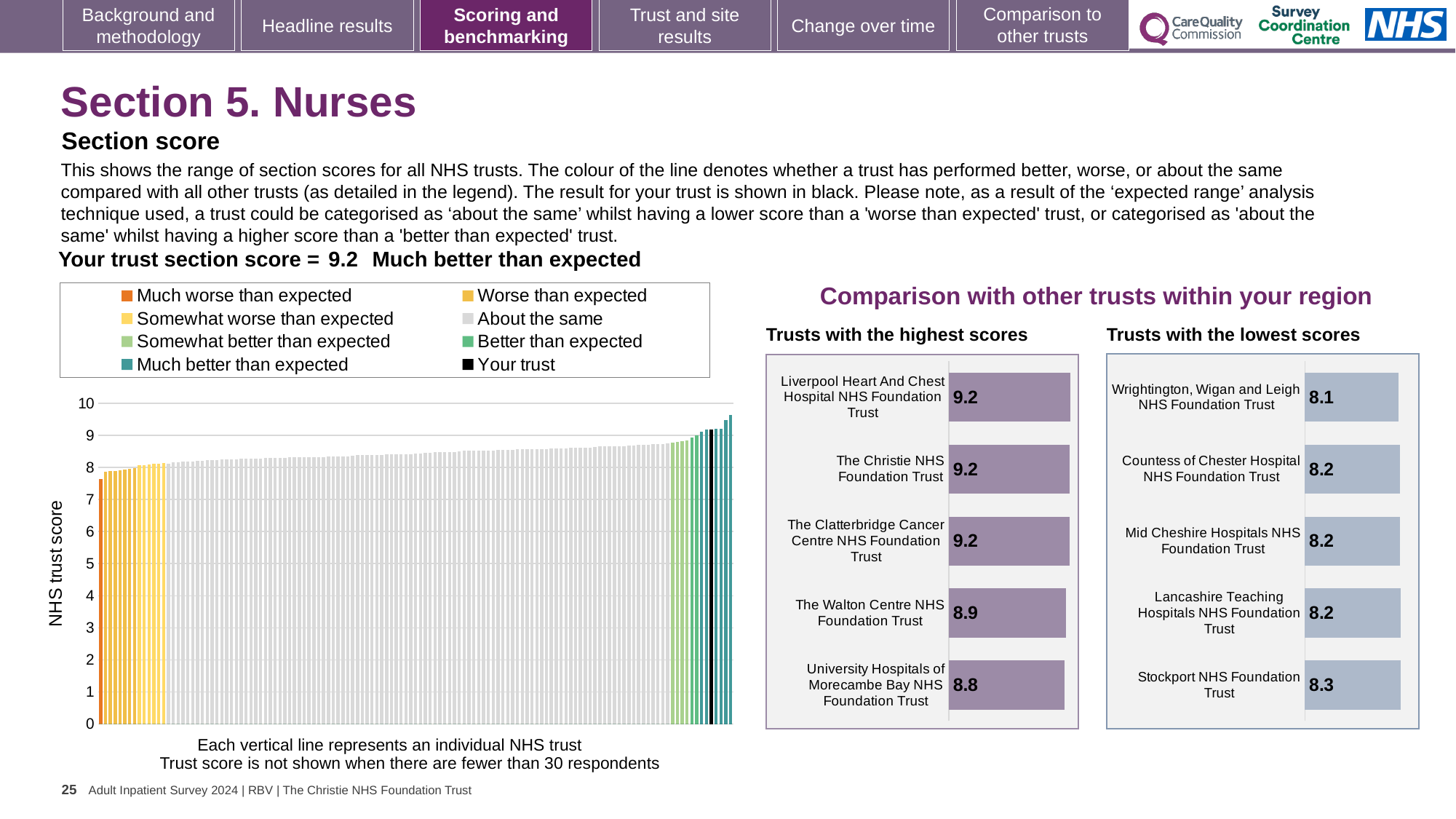
In the 'Trusts with the lowest scores' chart, what is the score for Wrightington, Wigan and Leigh NHS Foundation Trust? 8.1 What kind of chart is the 'Trusts with the highest scores' chart? Bar chart In the 'Trusts with the lowest scores' chart, what is the score for Stockport NHS Foundation Trust? 8.3 How many entries does the legend of the NHS trust score chart on the left list? 8 In the 'Trusts with the highest scores' chart, which has the larger score: The Walton Centre NHS Foundation Trust or University Hospitals of Morecambe Bay NHS Foundation Trust? The Walton Centre NHS Foundation Trust In the 'Trusts with the lowest scores' chart, which trust has the lowest score? Wrightington, Wigan and Leigh NHS Foundation Trust In the 'Trusts with the highest scores' chart, what is the score for University Hospitals of Morecambe Bay NHS Foundation Trust? 8.8 In the 'Trusts with the highest scores' chart, what is the score for The Walton Centre NHS Foundation Trust? 8.9 How many trusts are shown in the 'Trusts with the highest scores' chart? 5 In the 'Trusts with the lowest scores' chart, what is the difference between the scores of Stockport NHS Foundation Trust and Wrightington, Wigan and Leigh NHS Foundation Trust? 0.2 In the 'Trusts with the lowest scores' chart, which trust has the highest score? Stockport NHS Foundation Trust In the 'Trusts with the highest scores' chart, what is the difference between the scores of The Walton Centre NHS Foundation Trust and University Hospitals of Morecambe Bay NHS Foundation Trust? 0.1